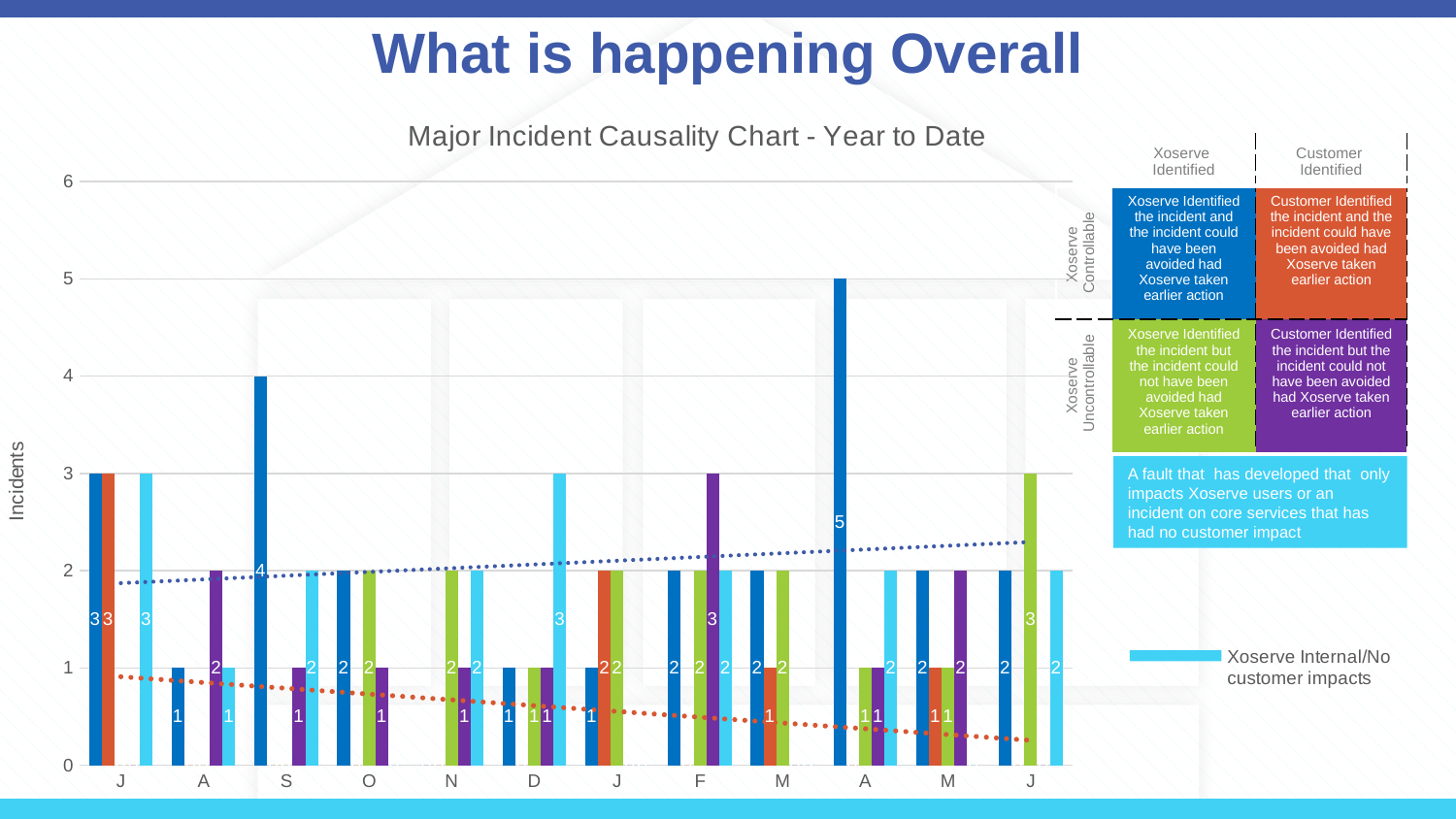
Which is larger: the dark blue bar for S or the dark blue bar for the first A? S What kind of chart is the Major Incident Causality Chart? Bar chart Does the orange dotted trend line rise or fall from left to right? Falls What is the label on the vertical axis of the chart? Incidents Does the blue dotted trend line rise or fall from left to right? Rises How many month categories are shown along the x axis? 12 What is the value of the tallest bar in the chart? 5 Is the tallest bar in the chart greater or less than 4? greater What is the value of the dark blue bar for the first J month? 3 What is the difference between the tallest bar (5) and the dark blue bar for S (4)? 1 What is the title of the chart? Major Incident Causality Chart - Year to Date What is the value of the dark blue bar for the month S? 4